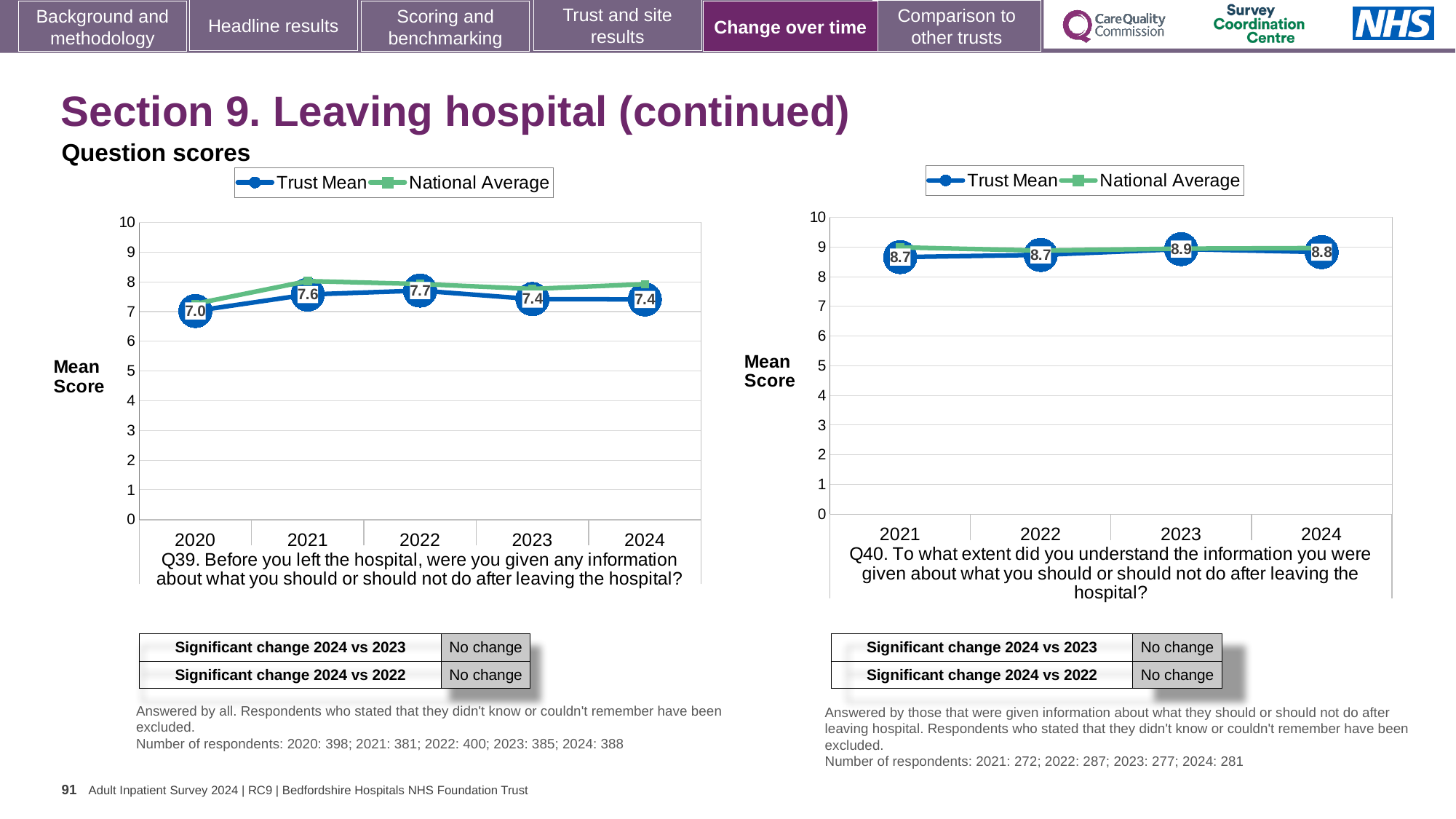
In the left chart (Q39), which year has the lowest Trust Mean score? 2020 In the right chart (Q40), which year has the highest Trust Mean score? 2023 In the left chart (Q39), what is the difference between the Trust Mean scores for 2022 and 2020? 0.7 In the right chart (Q40), is the Trust Mean score for 2021 greater or less than 8? greater What kind of chart is the left chart (Q39)? Line chart In the left chart (Q39), what is the Trust Mean score for 2020? 7.0 In the right chart (Q40), what is the Trust Mean score for 2024? 8.8 In the right chart (Q40), what is the Trust Mean score for 2023? 8.9 In the left chart (Q39), which year has the highest Trust Mean score? 2022 In the left chart (Q39), how many years are shown on the x axis? 5 How many series does the legend of the right chart (Q40) list? 2 In the left chart (Q39), what is the Trust Mean score for 2022? 7.7